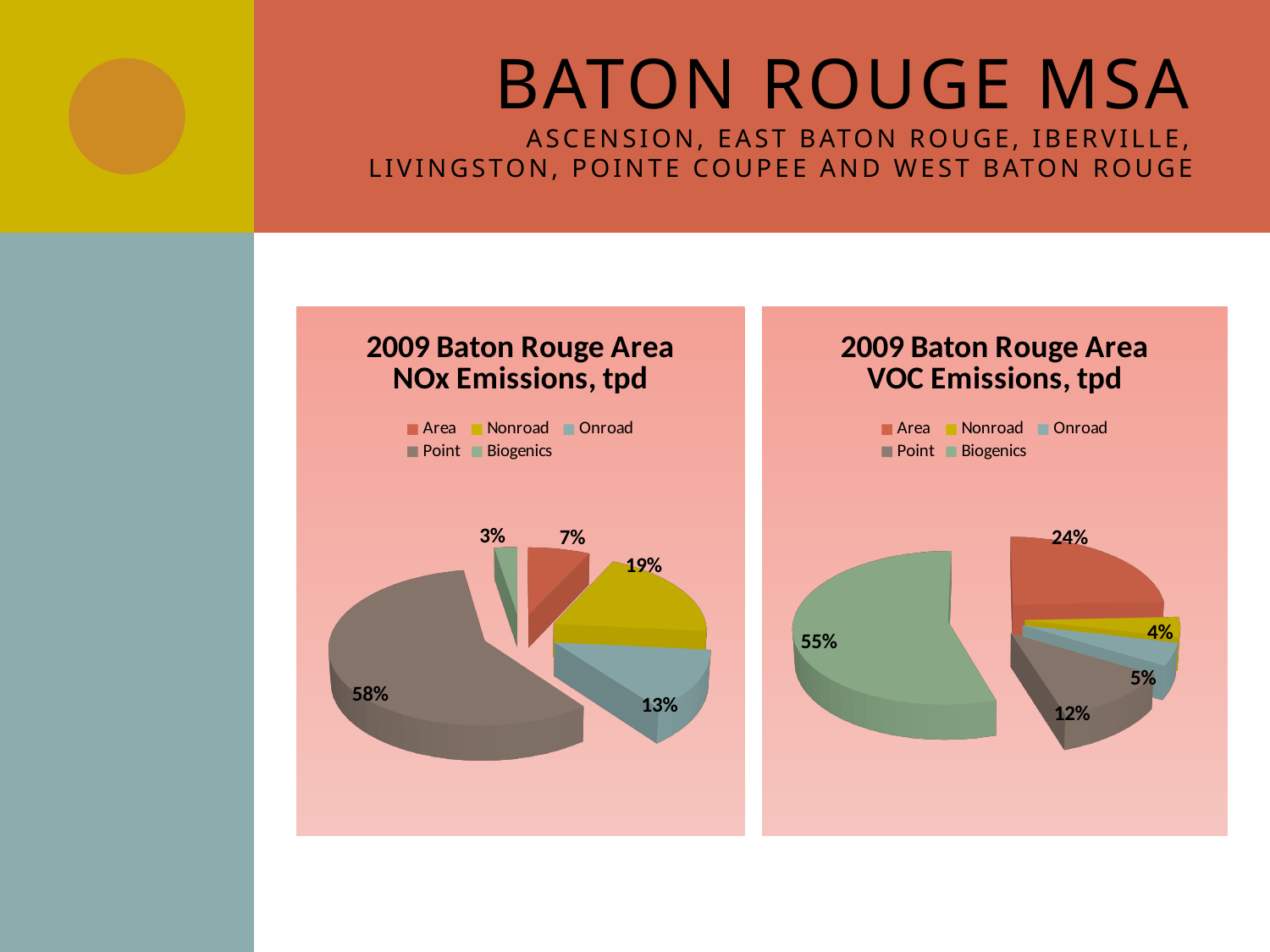
In the 2009 Baton Rouge Area VOC Emissions chart, which is larger, the Point slice or the Onroad slice? Point In the 2009 Baton Rouge Area NOx Emissions chart, which category has the largest slice? Point In the 2009 Baton Rouge Area NOx Emissions chart, what share of emissions comes from Point sources? 58% In the 2009 Baton Rouge Area NOx Emissions chart, which category has the smallest slice? Biogenics In the 2009 Baton Rouge Area NOx Emissions chart, what share of emissions comes from Nonroad sources? 19% In the 2009 Baton Rouge Area NOx Emissions chart, what is the difference in percentage points between the Nonroad and Onroad slices? 6 percentage points How many categories does the legend of the 2009 Baton Rouge Area VOC Emissions chart list? 5 In the 2009 Baton Rouge Area VOC Emissions chart, what share of emissions comes from Area sources? 24% What type of chart is the 2009 Baton Rouge Area NOx Emissions chart? Pie chart In the 2009 Baton Rouge Area VOC Emissions chart, what is the difference in percentage points between the Biogenics and Area slices? 31 percentage points In the 2009 Baton Rouge Area VOC Emissions chart, which category has the smallest slice? Nonroad